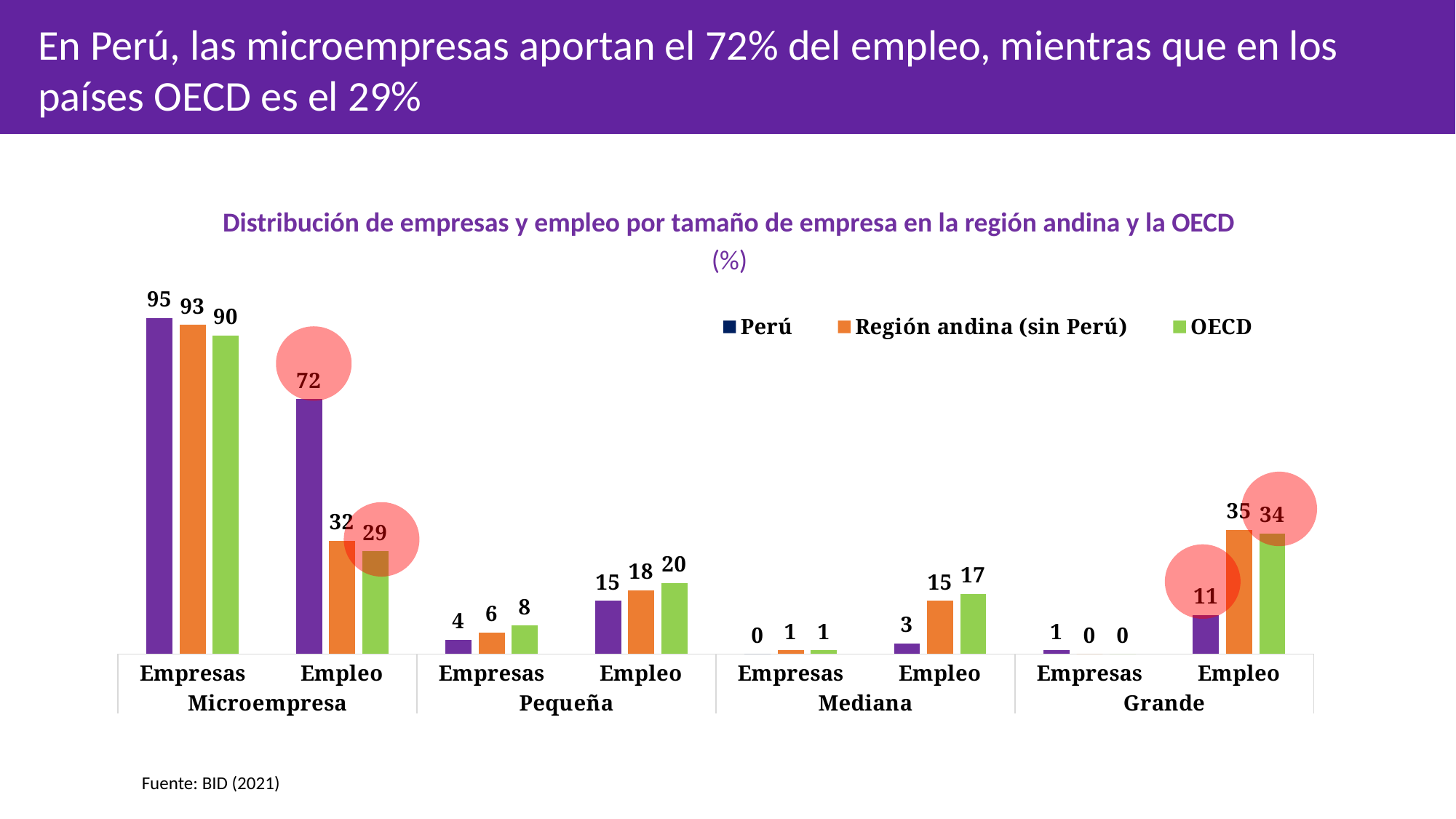
Which series has the highest value in the Empresas category under Microempresa? Perú Which is larger: the OECD value for Empleo under Pequeña or the OECD value for Empleo under Mediana? Empleo under Pequeña How many category groups (Empresas/Empleo pairs) are shown along the x axis? 4 What kind of chart is shown on the slide? Bar chart What is the source cited below the chart? BID (2021) What is the value for Perú in the Empleo category under Microempresa? 72 What is the value for Perú in the Empresas category under Pequeña? 4 What is the difference between the Perú and OECD values in the Empleo category under Microempresa? 43 Which series has the lowest value in the Empleo category under Grande? Perú How many series does the legend list? 3 What is the value for OECD in the Empleo category under Microempresa? 29 What is the value for Región andina (sin Perú) in the Empleo category under Grande? 35